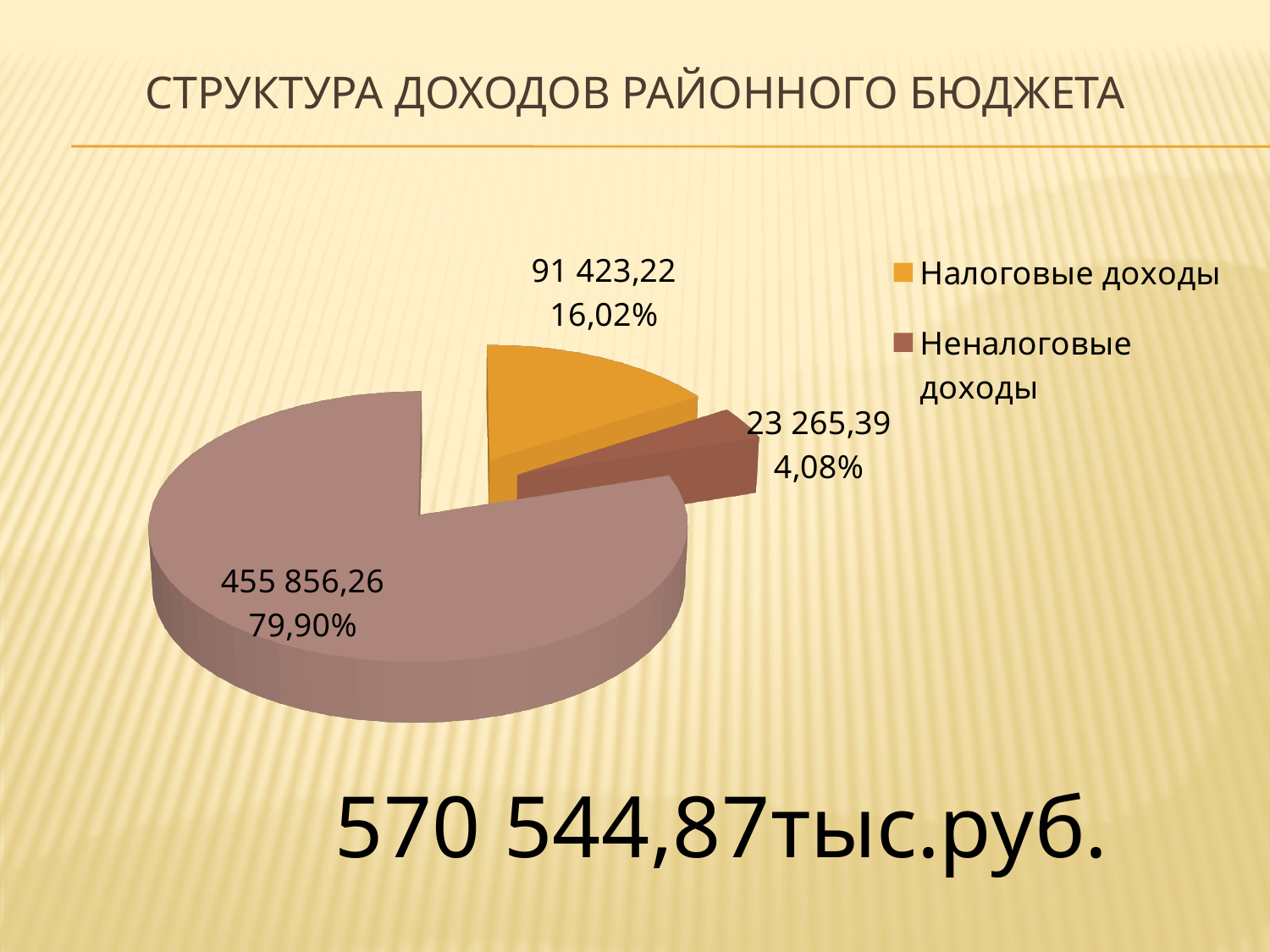
What is the title of the slide? СТРУКТУРА ДОХОДОВ РАЙОННОГО БЮДЖЕТА What share of the pie does Налоговые доходы represent? 16,02% What share of the pie does Неналоговые доходы represent? 4,08% How many slices does the pie chart have? 3 How many entries does the legend list? 2 What value is shown for Налоговые доходы? 91 423,22 What percentage is printed on the largest slice of the pie? 79,90% What is the difference between the values for Налоговые доходы and Неналоговые доходы? 68 157,83 What kind of chart is shown on the slide? Pie chart Which is larger, Налоговые доходы or Неналоговые доходы? Налоговые доходы What value is shown for Неналоговые доходы? 23 265,39 What is the total of all three slice values in the pie chart? 570 544,87